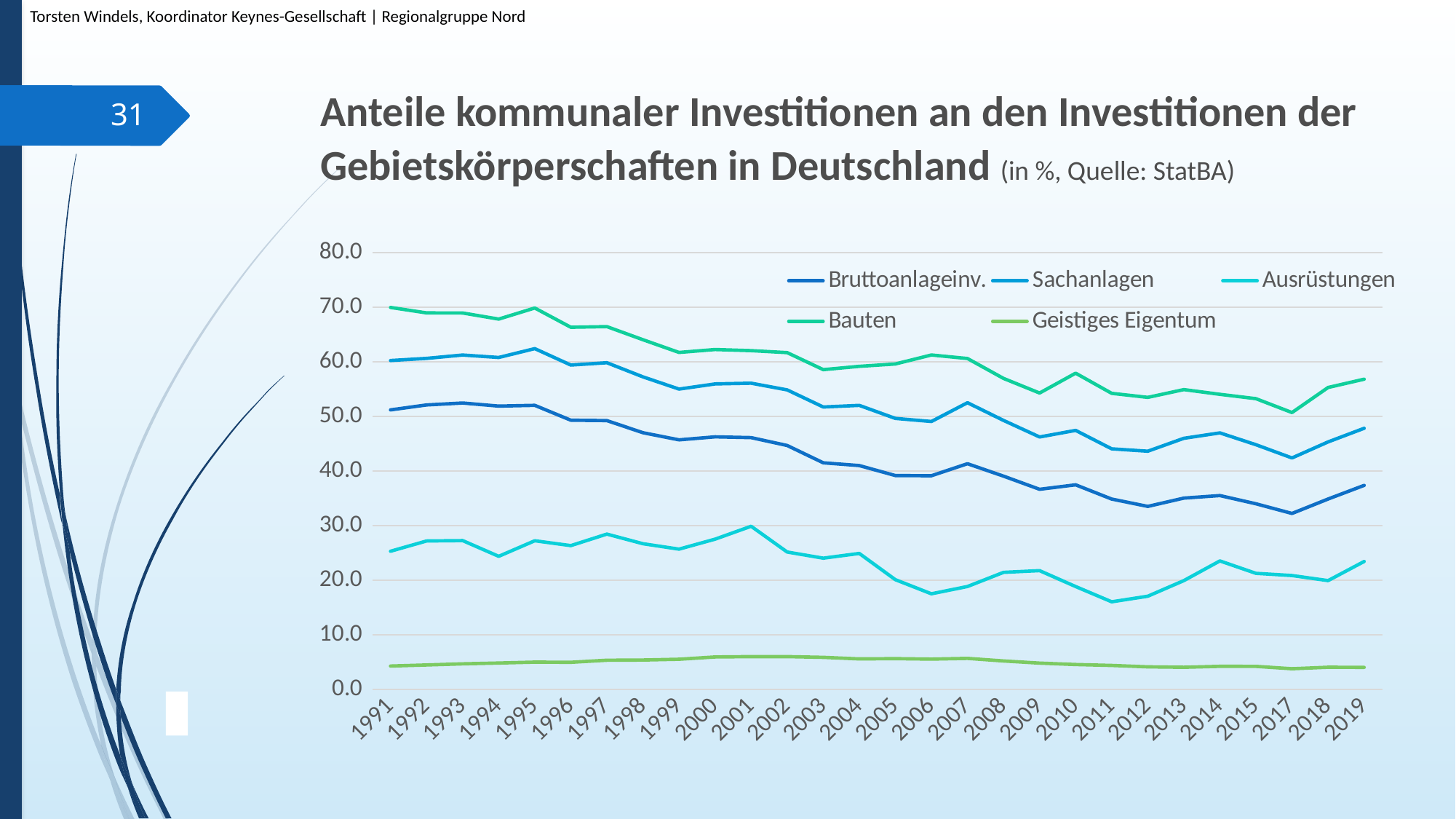
What source is given for the chart data in the title? StatBA What kind of chart is shown on the slide? line chart Which series has the highest value in 1991? Bauten Is the value for Ausrüstungen in 2011 greater or less than 20.0? less Which series has the lowest value in 2019? Geistiges Eigentum Does the Bruttoanlageinv. series generally rise or fall from 1991 to 2017? fall Is the value for Geistiges Eigentum in 2019 greater or less than 10.0? less Is the value for Bauten in 1991 greater or less than 60.0? greater In 2001, which is larger: Bauten or Ausrüstungen? Bauten How many years are labelled on the x axis? 28 How many series does the legend list? 5